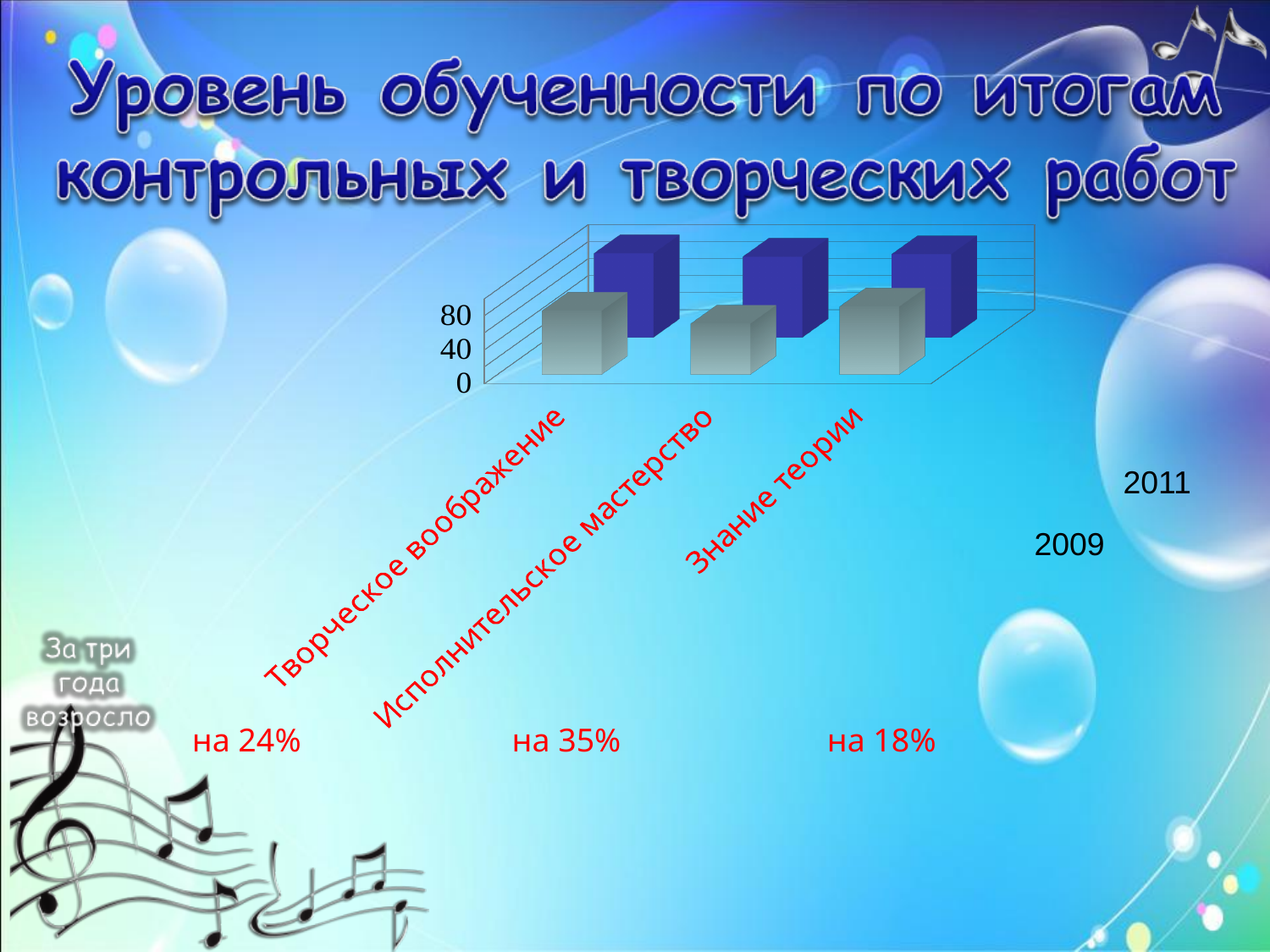
What kind of chart is shown on the slide? bar chart Which years are listed in the chart's legend? 2009 and 2011 Which category has the lowest value for the 2009 series? Исполнительское мастерство For Творческое воображение, which is larger: the 2009 value or the 2011 value? 2011 How many categories are shown on the x axis of the chart? 3 Is the 2011 value for Знание теории greater or less than 40? greater Is the 2009 value for Исполнительское мастерство greater or less than 80? less What is the highest tick value shown on the chart's vertical axis? 80 For Исполнительское мастерство, which is larger: the 2009 value or the 2011 value? 2011 How many series does the chart's legend list? 2 For Знание теории, which is larger: the 2009 value or the 2011 value? 2011